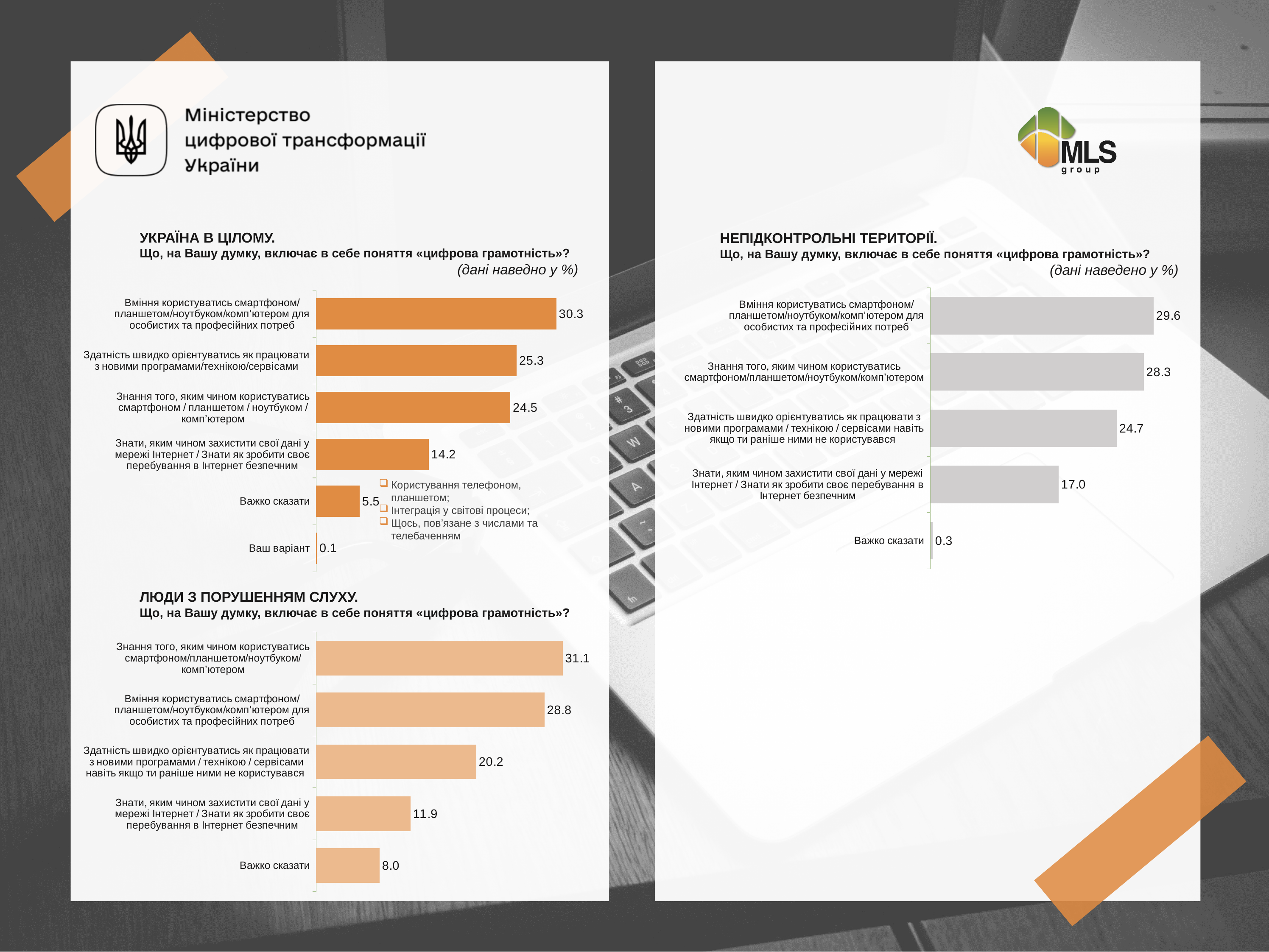
In the chart titled «ЛЮДИ З ПОРУШЕННЯМ СЛУХУ», which category has the highest value? Знання того, яким чином користуватись смартфоном/планшетом/ноутбуком/комп'ютером In the chart titled «НЕПІДКОНТРОЛЬНІ ТЕРИТОРІЇ», which is larger: «Вміння користуватись смартфоном/планшетом/ноутбуком/комп'ютером для особистих та професійних потреб» or «Знання того, яким чином користуватись смартфоном/планшетом/ноутбуком/комп'ютером»? Вміння користуватись смартфоном/планшетом/ноутбуком/комп'ютером для особистих та професійних потреб In the chart titled «УКРАЇНА В ЦІЛОМУ», which category has the lowest value? Ваш варіант In the chart titled «НЕПІДКОНТРОЛЬНІ ТЕРИТОРІЇ», what is the value for «Знати, яким чином захистити свої дані у мережі Інтернет / Знати як зробити своє перебування в Інтернет безпечним»? 17.0 In the chart titled «ЛЮДИ З ПОРУШЕННЯМ СЛУХУ», what is the difference between the highest value and the value for «Здатність швидко орієнтуватись як працювати з новими програмами / технікою / сервісами»? 10.9 How many categories are shown in the chart titled «НЕПІДКОНТРОЛЬНІ ТЕРИТОРІЇ»? 5 In the chart titled «УКРАЇНА В ЦІЛОМУ», what is the difference between «Здатність швидко орієнтуватись як працювати з новими програмами/технікою/сервісами» and «Знати, яким чином захистити свої дані у мережі Інтернет»? 11.1 What type of chart is the chart titled «НЕПІДКОНТРОЛЬНІ ТЕРИТОРІЇ»? Bar chart In the chart titled «УКРАЇНА В ЦІЛОМУ», what is the value for «Вміння користуватись смартфоном/планшетом/ноутбуком/комп'ютером для особистих та професійних потреб»? 30.3 In the chart titled «ЛЮДИ З ПОРУШЕННЯМ СЛУХУ», what is the value for «Важко сказати»? 8.0 What colour are the bars in the chart titled «НЕПІДКОНТРОЛЬНІ ТЕРИТОРІЇ»? Grey How many categories are shown in the chart titled «УКРАЇНА В ЦІЛОМУ»? 6